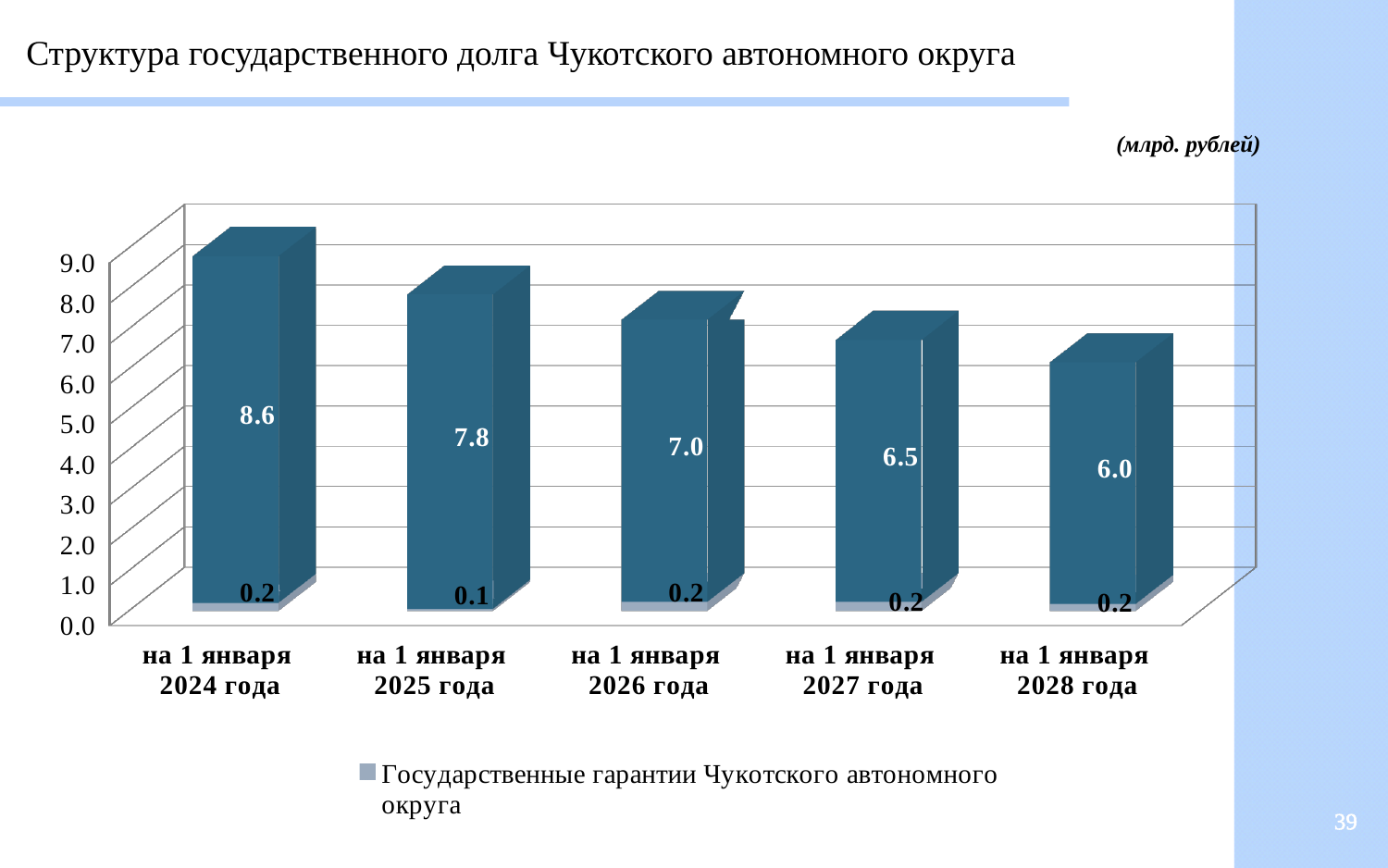
What is the total of the stacked bar for на 1 января 2024 года? 8.8 What is the difference between the dark blue segment values for на 1 января 2024 года and на 1 января 2028 года? 2.6 How many dates are shown on the x axis of the chart? 5 What kind of chart is shown on the slide? bar chart For which date is the dark blue segment the highest? на 1 января 2024 года What is the value of the dark blue segment for на 1 января 2027 года? 6.5 What is the value of the Государственные гарантии Чукотского автономного округа series for на 1 января 2025 года? 0.1 In what units are the chart values given? млрд. рублей For which date is the Государственные гарантии Чукотского автономного округа value the lowest? на 1 января 2025 года Do the dark blue segment values rise or fall from на 1 января 2024 года to на 1 января 2028 года? fall Which has the larger dark blue segment value: на 1 января 2026 года or на 1 января 2027 года? на 1 января 2026 года What is the value of the dark blue segment for на 1 января 2024 года? 8.6